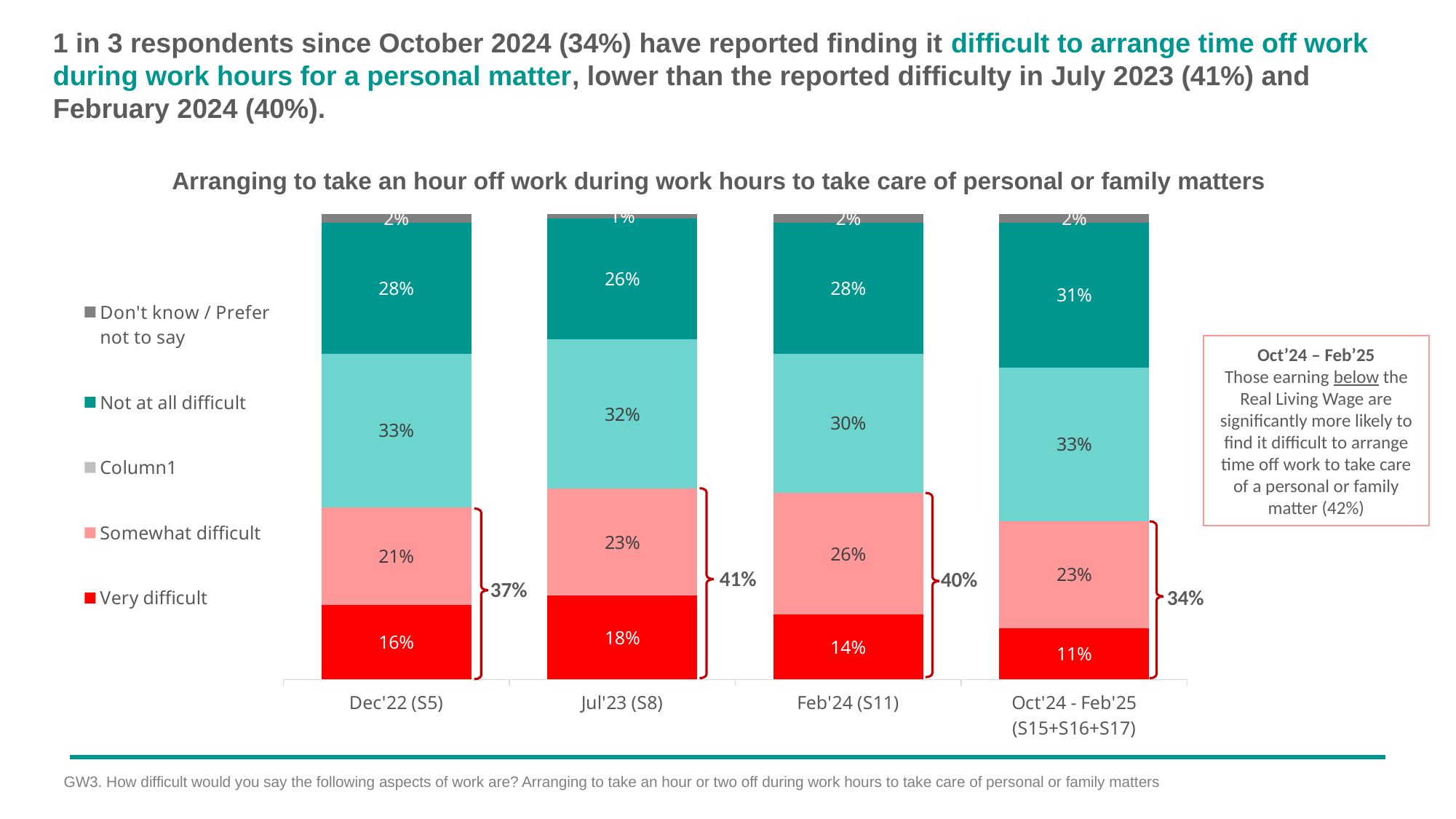
What percentage of respondents said 'Very difficult' in Dec'22 (S5)? 16% Which has the larger 'Not at all difficult' value, Jul'23 (S8) or Feb'24 (S11)? Feb'24 (S11) From Jul'23 (S8) onward, does the 'Very difficult' percentage rise or fall across the periods? Fall Which period has the highest 'Very difficult' percentage? Jul'23 (S8) What type of chart is shown on the slide? Stacked bar chart How many series does the legend list? 5 What is the 'Not at all difficult' value for Oct'24 - Feb'25 (S15+S16+S17)? 31% How many percentage points higher is 'Somewhat difficult' in Feb'24 (S11) than in Dec'22 (S5)? 5 percentage points What combined 'difficult' percentage is shown by the bracket for Jul'23 (S8)? 41% What is the 'Don't know / Prefer not to say' value for Jul'23 (S8)? 1% Which period has the lowest 'Very difficult' percentage? Oct'24 - Feb'25 (S15+S16+S17) How many survey periods are shown on the x axis? 4